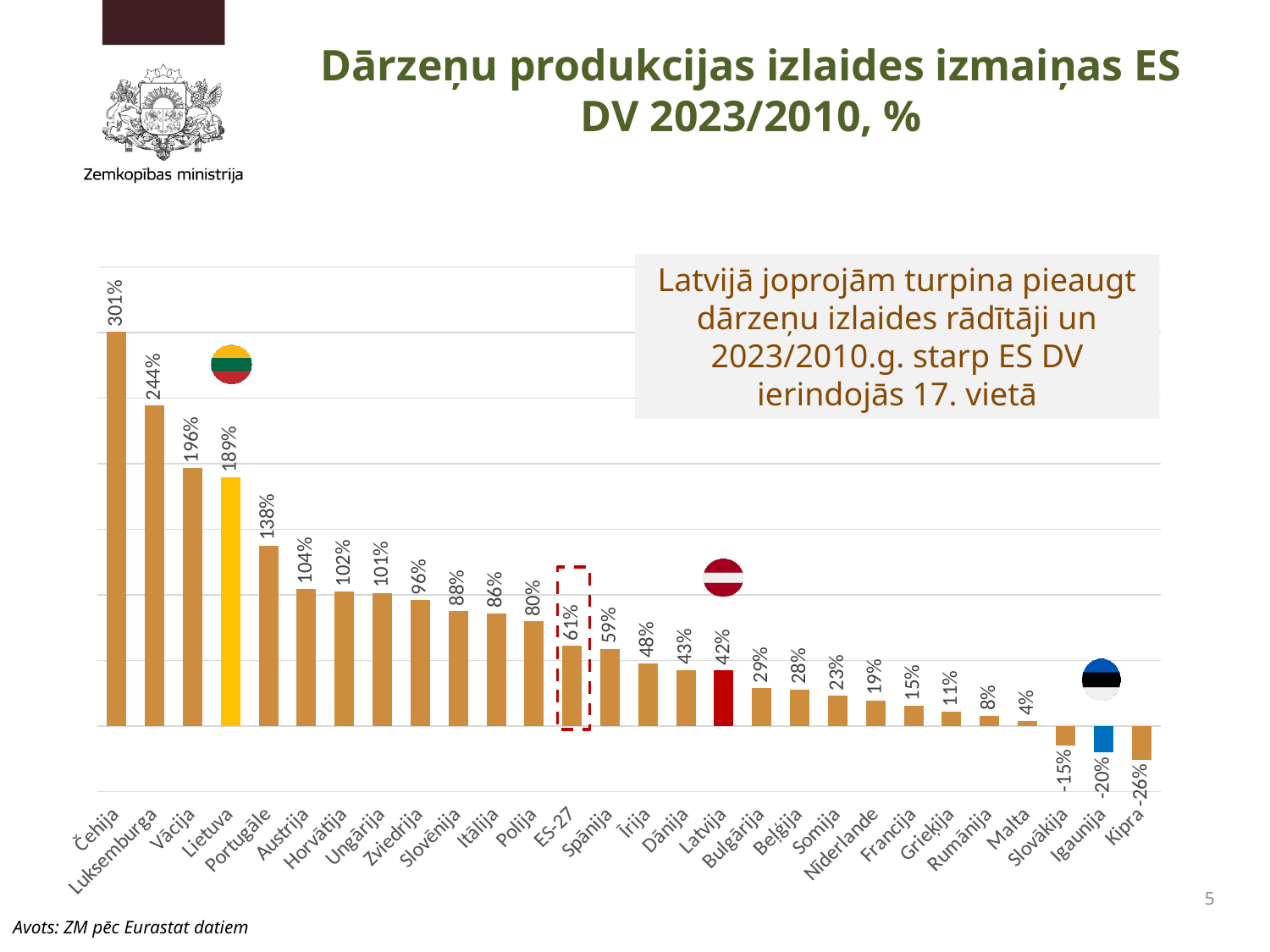
What kind of chart is shown on the slide? Bar chart What is the value for Latvija? 42% What is the difference between the values for ES-27 and Latvija? 19% How many categories are shown on the x axis? 28 Which country has the highest value? Čehija Which country has the lowest value? Kipra What is the difference between the values for Čehija and Luksemburga? 57% Do the values rise or fall from left to right along the x axis? Fall What is the value for Igaunija? -20% What is the value for ES-27? 61% Which is larger, the value for Portugāle or the value for Austrija? Portugāle What is the value for Lietuva? 189%